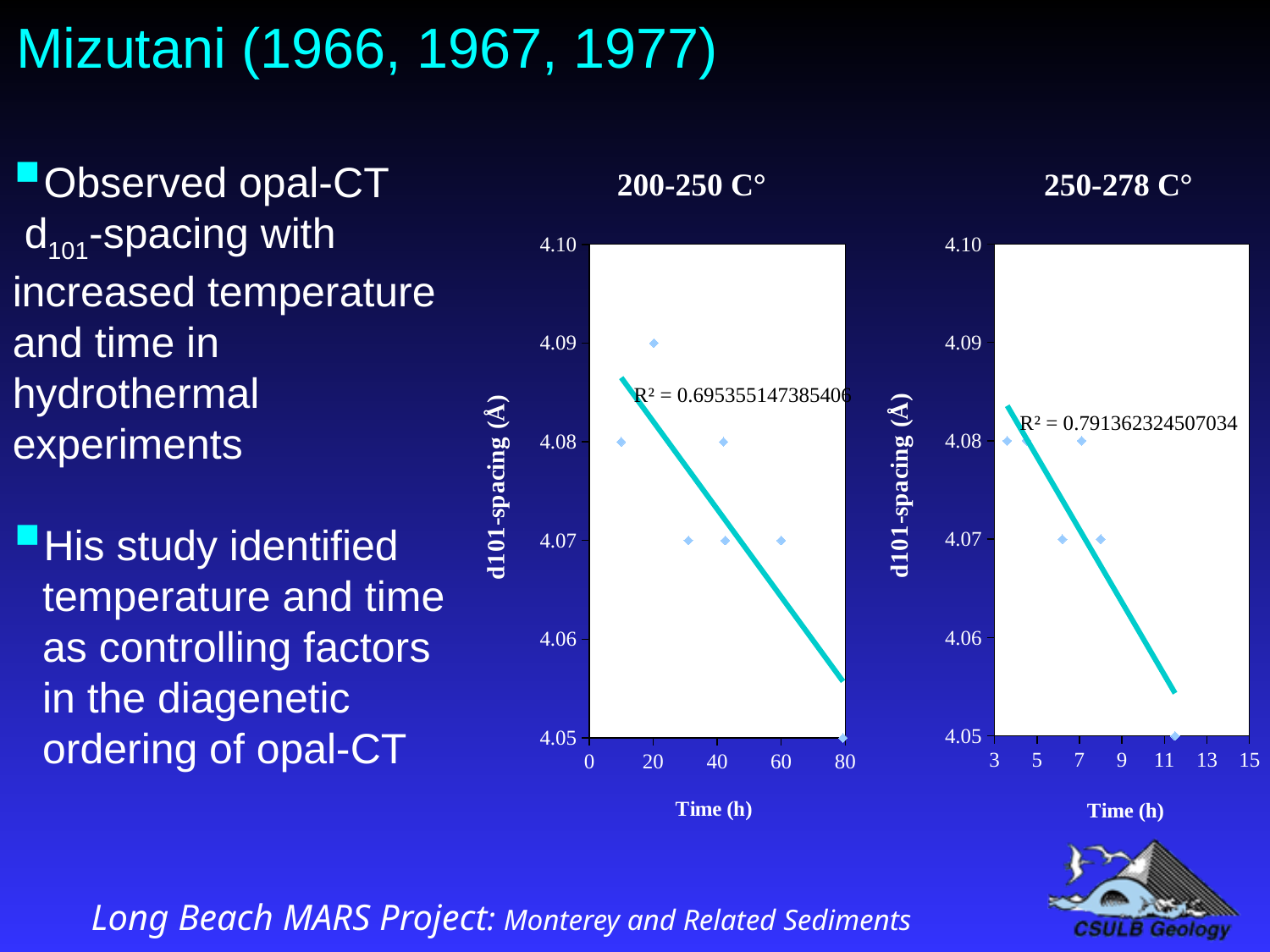
In the "250-278 C°" chart, is the d101-spacing value of the point near 11 h greater or less than 4.06? less What is the y-axis title of the "250-278 C°" chart? d101-spacing (Å) In the "200-250 C°" chart, do the d101-spacing values rise or fall as time increases along the x axis? fall What is the x-axis title of the "200-250 C°" chart? Time (h) In the "200-250 C°" chart, what is the R² value printed on the chart? R² = 0.695355147385406 In the "250-278 C°" chart, does the trendline rise or fall as time increases? fall How many data points are plotted in the "250-278 C°" chart? 6 In the "200-250 C°" chart, is the d101-spacing value of the point at about 20 h greater or less than 4.08? greater In the "250-278 C°" chart, what is the R² value printed on the chart? R² = 0.791362324507034 Which chart has the higher R² value, "200-250 C°" or "250-278 C°"? 250-278 C° What kind of chart is the "200-250 C°" chart? scatter chart In the "200-250 C°" chart, is the d101-spacing value of the point at 80 h greater or less than 4.06? less